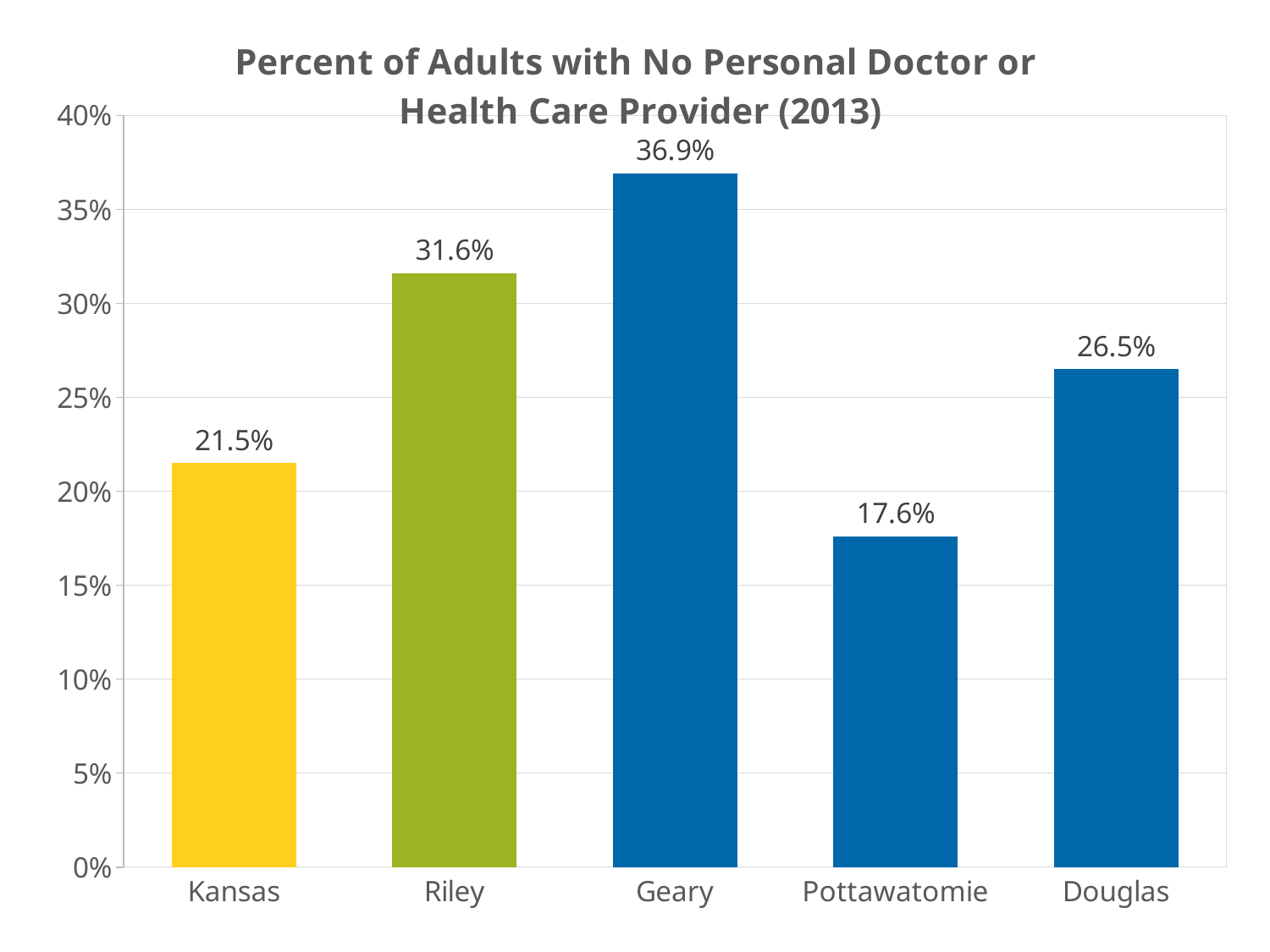
Which category has the lowest value? Pottawatomie Which is larger, the value for Douglas or the value for Kansas? Douglas What is the value for Kansas? 21.5% What is the title of the chart? Percent of Adults with No Personal Doctor or Health Care Provider (2013) What is the value for Pottawatomie? 17.6% Is the value for Geary greater or less than 35%? greater What is the difference between the values for Geary and Riley? 5.3% What kind of chart is this? bar chart What is the value for Riley? 31.6% What is the difference between the values for Douglas and Kansas? 5.0% How many categories are shown on the x axis? 5 Which category has the highest value? Geary